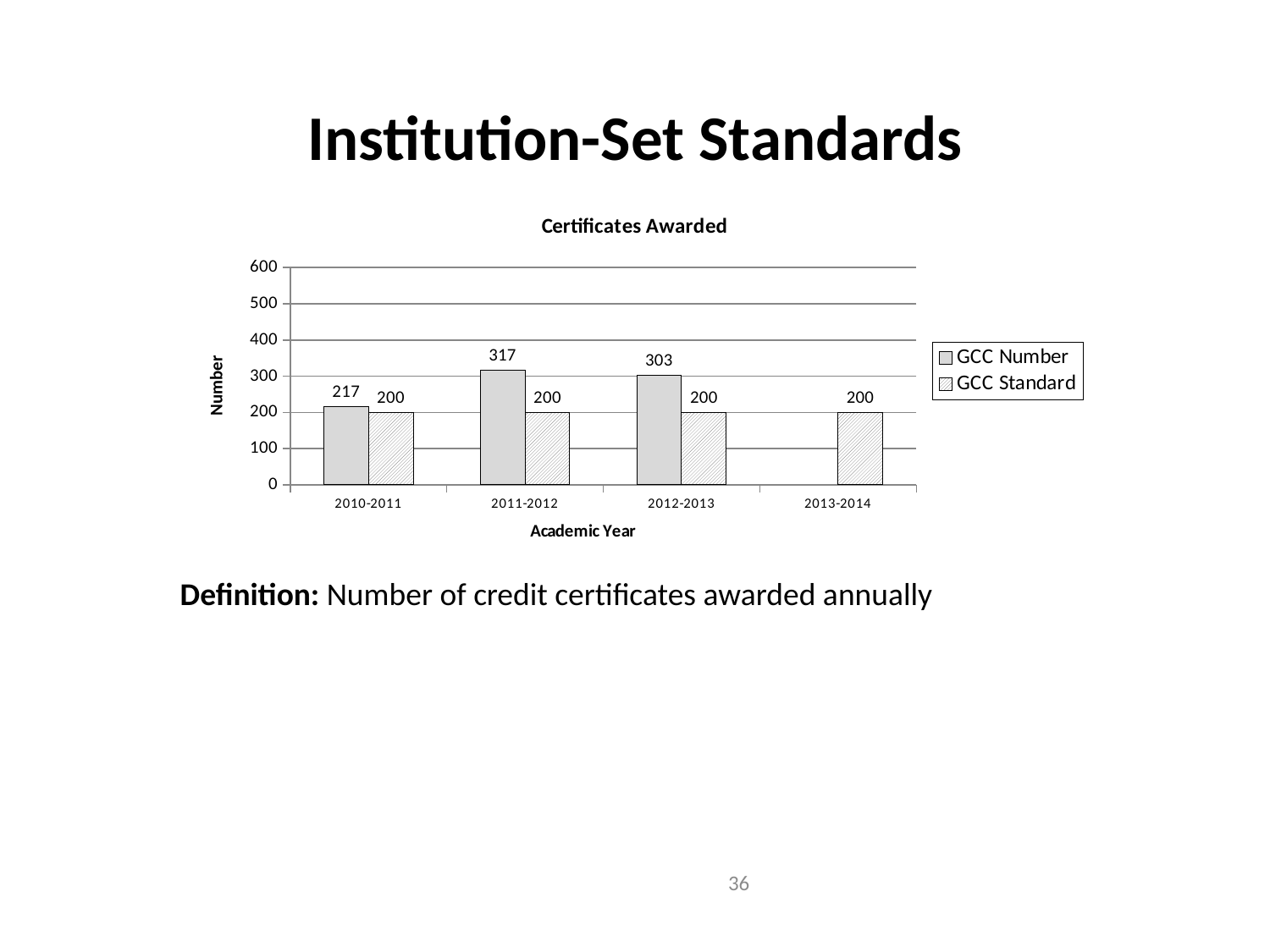
What is the GCC Number value for 2010-2011? 217 What kind of chart is shown on the slide? bar chart What is the title of the chart? Certificates Awarded Which is larger for 2010-2011, the GCC Number or the GCC Standard? GCC Number How many series does the legend list? 2 What is the GCC Number value for 2011-2012? 317 How many academic years are shown on the x axis? 4 What is the GCC Standard value for 2013-2014? 200 Is the GCC Number for 2011-2012 greater or less than 300? greater Which academic year has the highest GCC Number? 2011-2012 What is the difference between the GCC Number and the GCC Standard for 2012-2013? 103 Which academic year has the lowest GCC Number among those with a GCC Number bar? 2010-2011